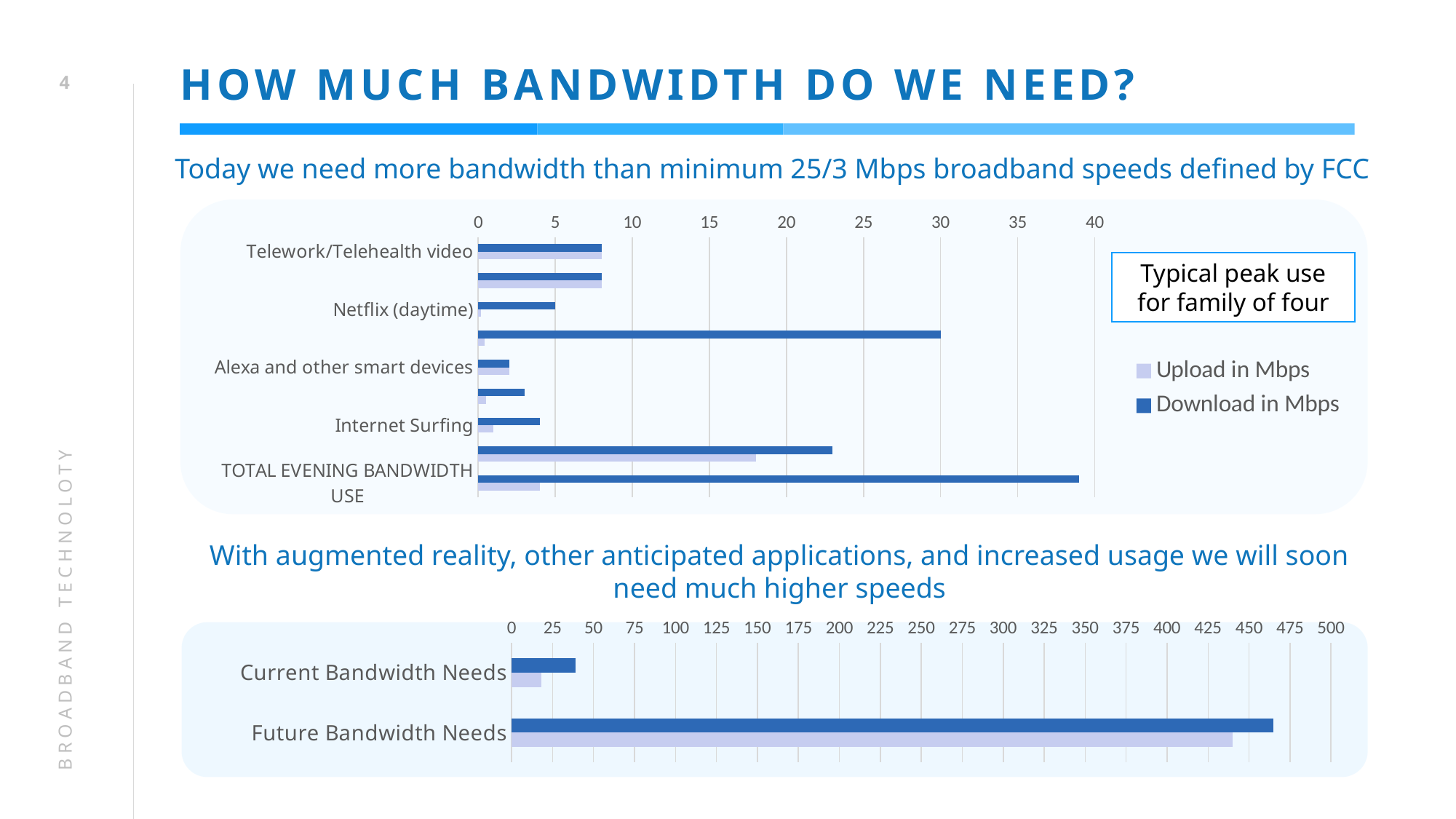
What does the text box next to the top chart say? Typical peak use for family of four In the top chart, is the Download in Mbps value for Telework/Telehealth video greater or less than 10? less What kind of chart is the top chart? bar chart How many categories are shown in the bottom chart? 2 In the bottom chart, is the Download in Mbps value for Current Bandwidth Needs greater or less than 50? less In the bottom chart, which category has the larger Download in Mbps value, Current Bandwidth Needs or Future Bandwidth Needs? Future Bandwidth Needs In the top chart, is the Download in Mbps value for TOTAL EVENING BANDWIDTH USE greater or less than 35? greater What are the two legend entries of the top chart? Upload in Mbps, Download in Mbps In the top chart, which has the larger Download in Mbps value, Telework/Telehealth video or Netflix (daytime)? Telework/Telehealth video How many series does the legend of the top chart list? 2